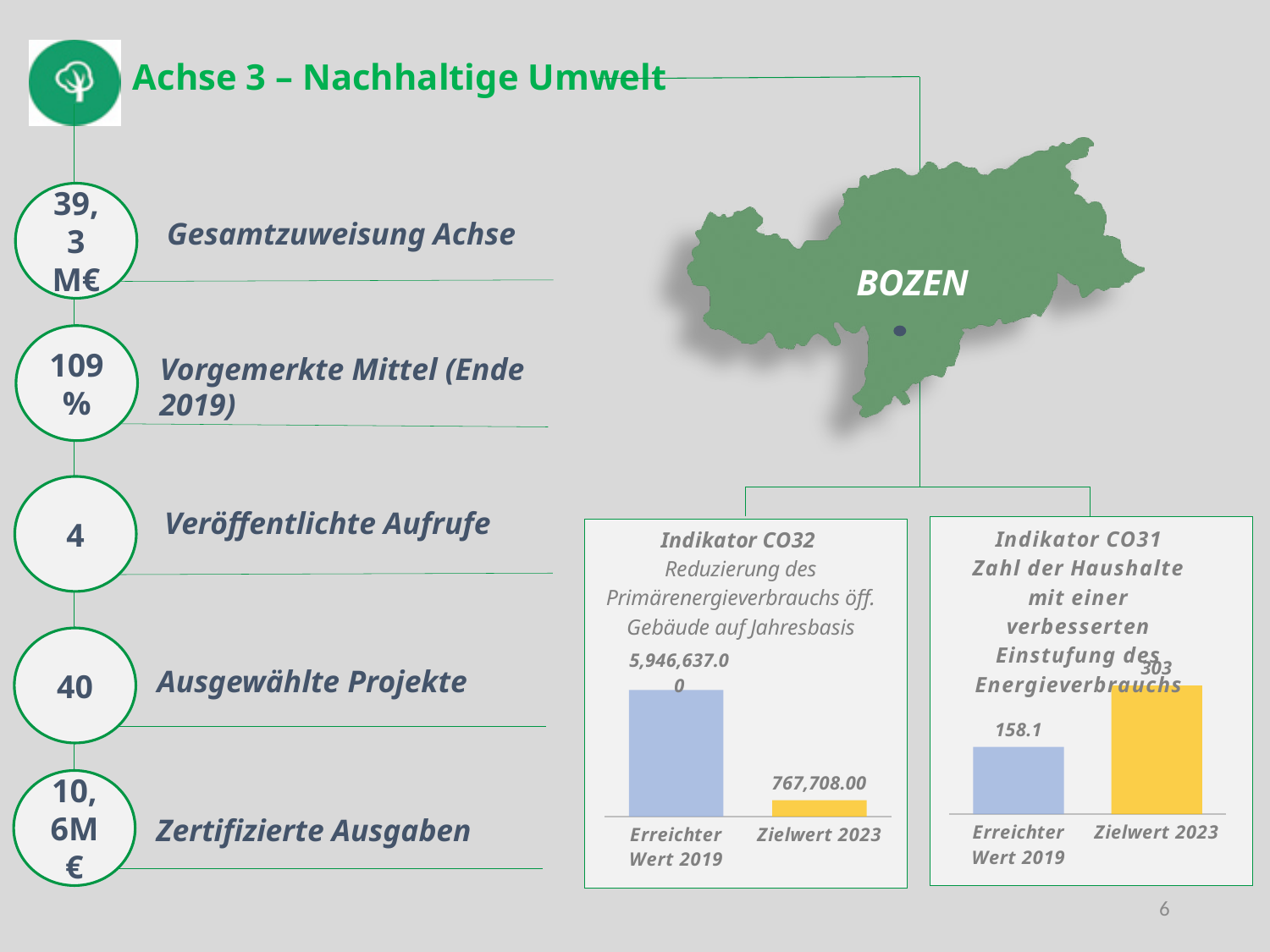
In the Indikator CO32 chart, what is the value for Erreichter Wert 2019? 5,946,637.00 In the Indikator CO31 chart, is the value for Zielwert 2023 larger or smaller than the value for Erreichter Wert 2019? larger In the Indikator CO32 chart, which category has the higher value? Erreichter Wert 2019 In the Indikator CO31 chart, which category has the lower value? Erreichter Wert 2019 In the Indikator CO31 chart, what is the value for Zielwert 2023? 303 What type of chart is the Indikator CO31 chart? bar chart In the Indikator CO32 chart, what is the value for Zielwert 2023? 767,708.00 In the Indikator CO31 chart, what colour is the Zielwert 2023 bar? yellow How many categories are shown in the Indikator CO32 chart? 2 In the Indikator CO31 chart, what is the difference between Zielwert 2023 and Erreichter Wert 2019? 144.9 In the Indikator CO32 chart, what is the difference between Erreichter Wert 2019 and Zielwert 2023? 5,178,929.00 In the Indikator CO31 chart, what is the value for Erreichter Wert 2019? 158.1